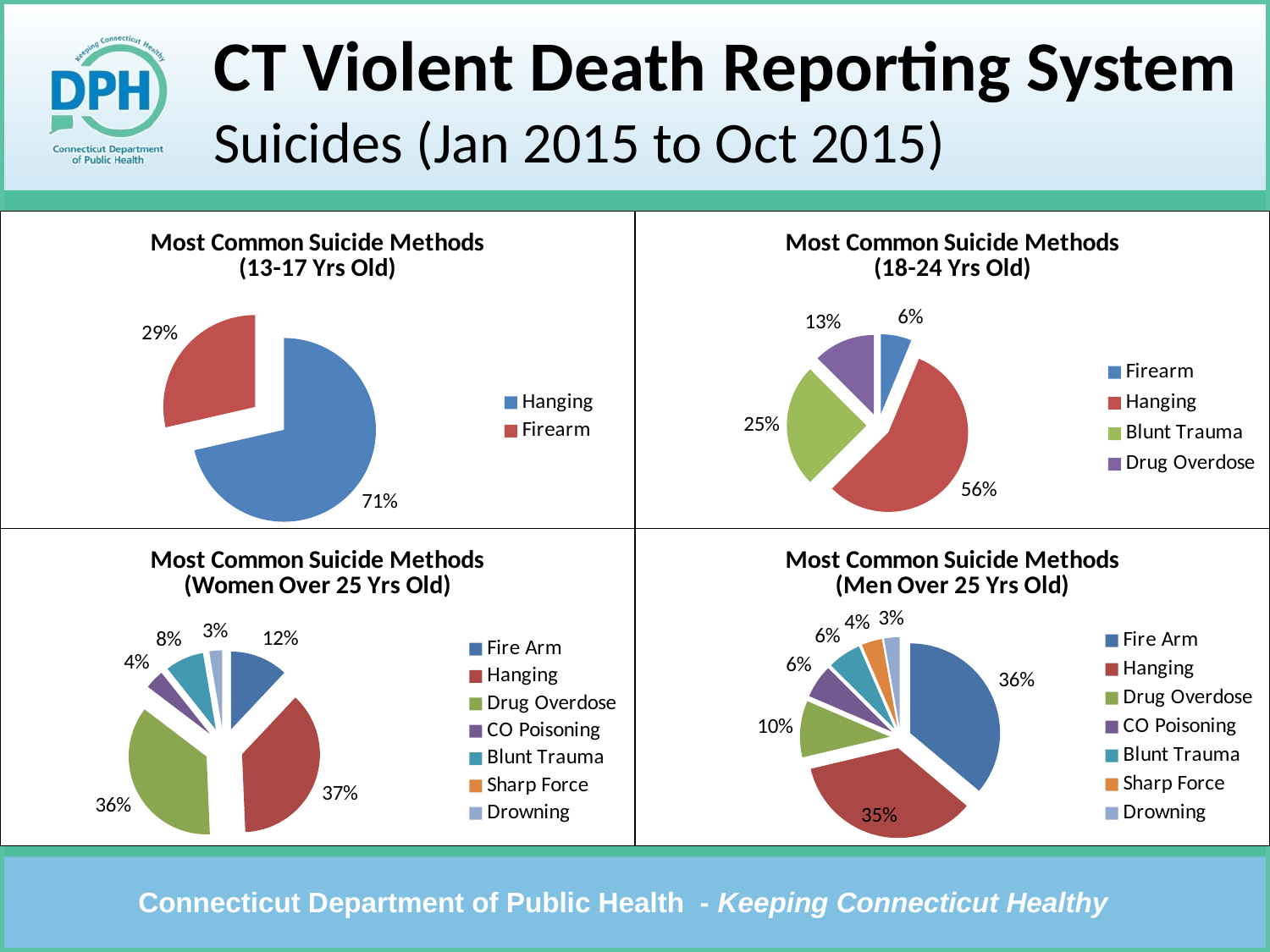
In the 'Most Common Suicide Methods (Men Over 25 Yrs Old)' chart, which is larger, Fire Arm or Drug Overdose? Fire Arm In the 'Most Common Suicide Methods (18-24 Yrs Old)' chart, which method has the largest share? Hanging In the 'Most Common Suicide Methods (18-24 Yrs Old)' chart, which method has the smallest share? Firearm In the 'Most Common Suicide Methods (Women Over 25 Yrs Old)' chart, what percentage is Hanging? 37% In the 'Most Common Suicide Methods (Women Over 25 Yrs Old)' chart, what percentage is Fire Arm? 12% In the 'Most Common Suicide Methods (18-24 Yrs Old)' chart, what percentage is Blunt Trauma? 25% How many methods does the legend list in the 'Most Common Suicide Methods (Men Over 25 Yrs Old)' chart? 7 In the 'Most Common Suicide Methods (Men Over 25 Yrs Old)' chart, what percentage is Drug Overdose? 10% In the 'Most Common Suicide Methods (13-17 Yrs Old)' chart, what percentage is Hanging? 71% In the 'Most Common Suicide Methods (18-24 Yrs Old)' chart, what is the difference in percentage points between Hanging and Drug Overdose? 43 In the 'Most Common Suicide Methods (13-17 Yrs Old)' chart, what percentage is Firearm? 29% What type of chart is used for 'Most Common Suicide Methods (13-17 Yrs Old)'? Pie chart